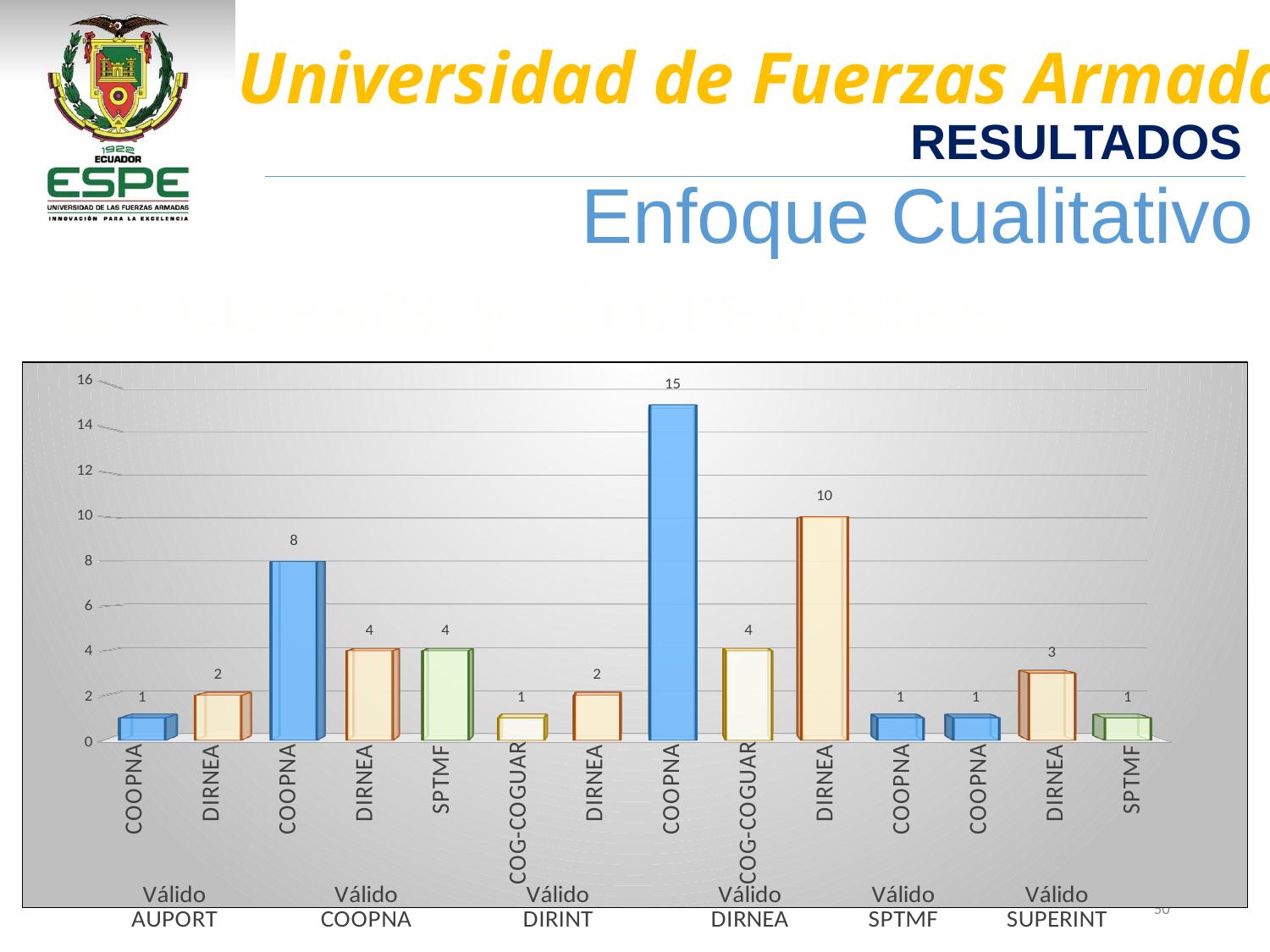
What is the difference between the COOPNA bar and the DIRNEA bar in the DIRNEA group? 5 What is the value of the DIRNEA bar in the SUPERINT group? 3 What is the total of the three bars in the COOPNA group? 16 How many top-level groups (AUPORT, COOPNA, etc.) are shown on the x axis? 6 What is the value of the COOPNA bar in the DIRNEA group? 15 What is the maximum value shown on the vertical axis? 16 How many bars are plotted in the chart? 14 What is the value of the COOPNA bar in the COOPNA group? 8 What kind of chart is shown on the slide? bar chart What is the value of the DIRNEA bar in the DIRNEA group? 10 Which bar has the highest value in the chart? COOPNA in the DIRNEA group Which is larger: the COOPNA bar in the COOPNA group or the DIRNEA bar in the DIRNEA group? DIRNEA bar in the DIRNEA group